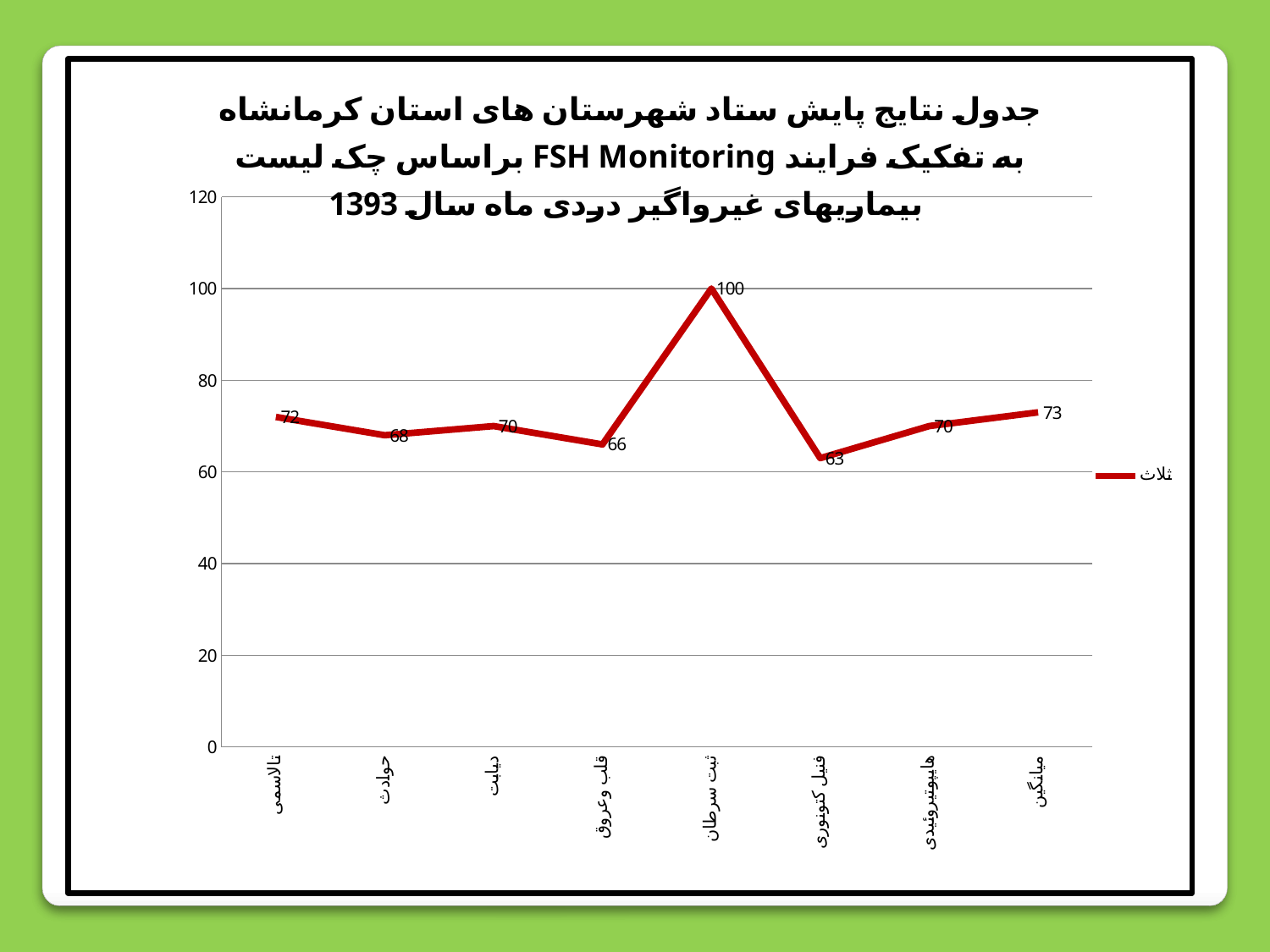
What is the value for میانگین? 73 Which is larger, the value for تالاسمی or the value for حوادث? تالاسمی What is the value for قلب وعروق? 66 Which category has the highest value? ثبت سرطان What is the value for ثبت سرطان? 100 What is the name of the series shown in the legend? ثلاث What type of chart is shown on the slide? line chart How many series does the legend list? 1 What is the value for فنیل کتونوری? 63 Which category has the lowest value? فنیل کتونوری How many categories are plotted on the x axis? 8 What is the difference between the values for ثبت سرطان and فنیل کتونوری? 37